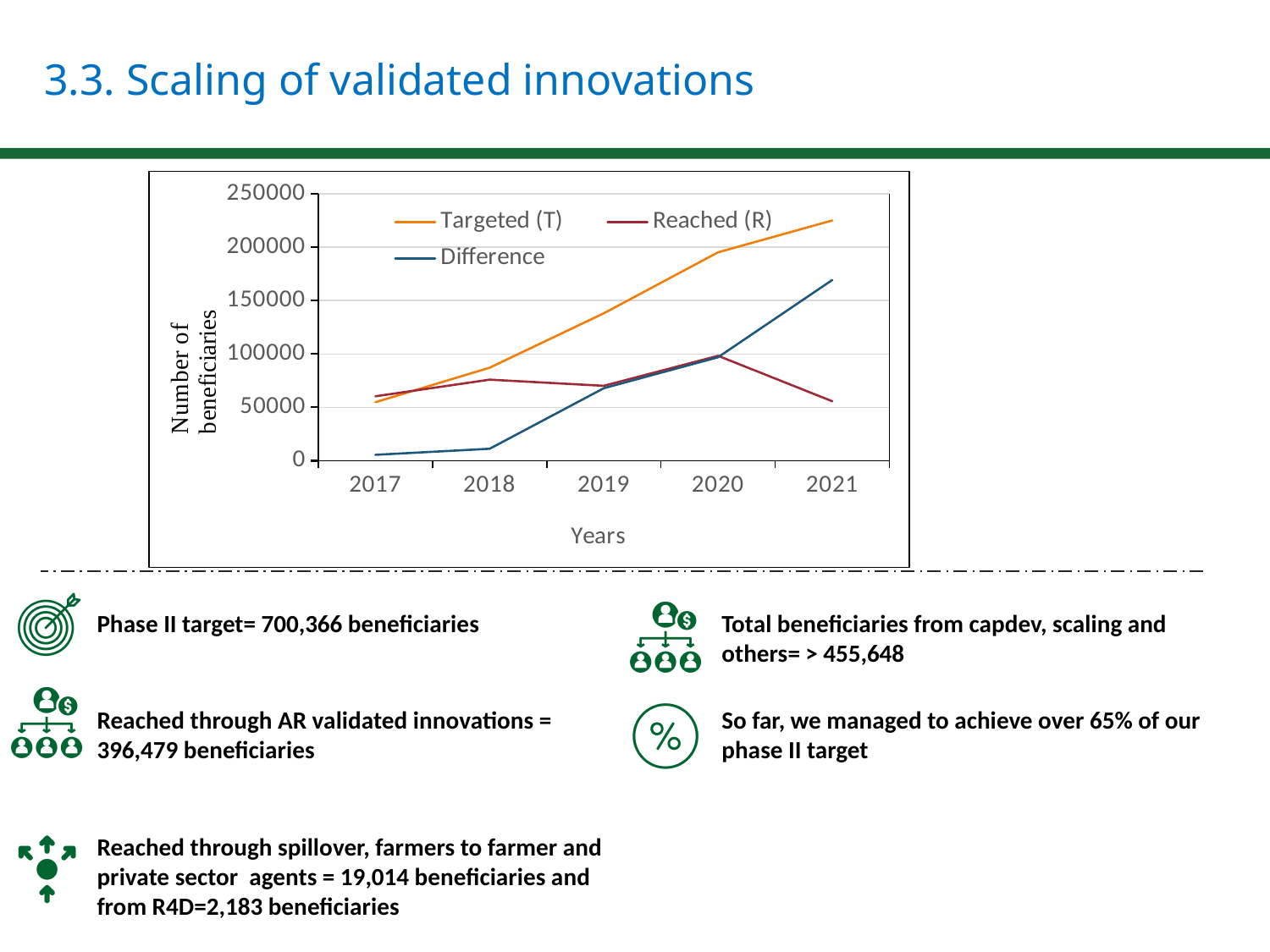
In which year is the Difference value lowest? 2017 How many series does the chart's legend list? 3 How many years are plotted along the x axis of the chart? 5 Is the Reached (R) value for 2021 greater or less than 100000? less What kind of chart is shown on the slide? line chart Is the Difference value for 2018 greater or less than 50000? less In which year is the Targeted (T) value highest? 2021 In which year is the Reached (R) value highest? 2020 In 2021, which is larger: the Targeted (T) value or the Reached (R) value? Targeted (T) Does the Targeted (T) line rise or fall from 2017 to 2021? rise What is the label of the chart's y axis? Number of beneficiaries Is the Targeted (T) value for 2021 greater or less than 200000? greater